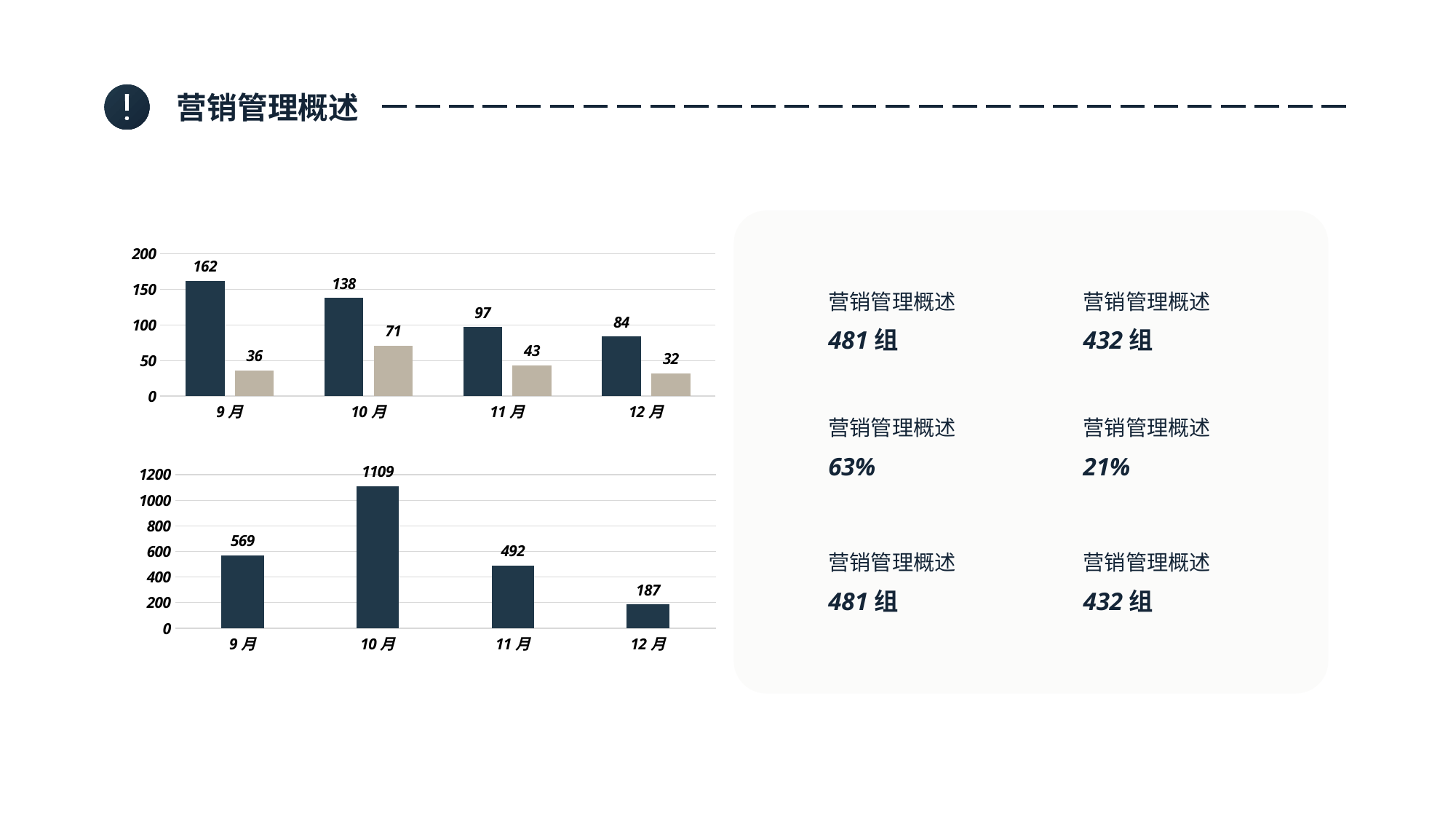
In the top chart, how many months are shown on the x axis? 4 In the top chart, what is the difference between the dark blue bar and the beige bar for 11 月? 54 In the bottom chart, which is larger, the value for 9 月 or the value for 12 月? 9 月 In the bottom chart, which month has the lowest value? 12 月 In the top chart, what is the value of the beige bar for 10 月? 71 In the top chart, which month has the highest dark blue bar? 9 月 In the bottom chart, what is the value for 10 月? 1109 In the bottom chart, what is the difference between the values for 9 月 and 11 月? 77 In the top chart, what is the value of the dark blue bar for 9 月? 162 In the top chart, do the dark blue bars rise or fall from 9 月 to 12 月? fall What type of chart is the bottom chart? bar chart In the top chart, which month has the lowest beige bar? 12 月